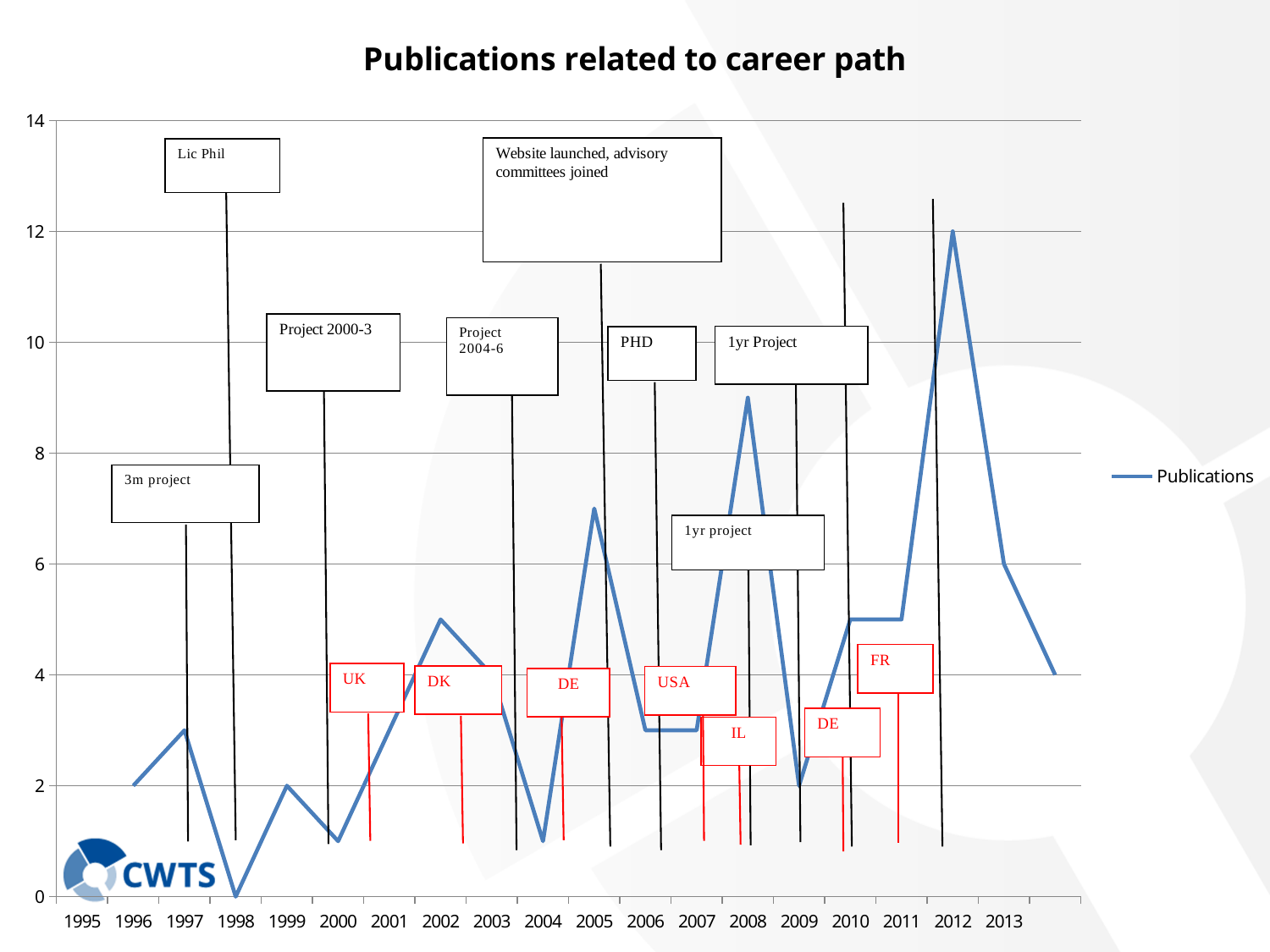
Is the value for Publications in 2009 greater or less than 4? less What is the value of Publications in 2012? 12 Do the publications rise or fall from 2012 to 2013? fall What is the value of Publications in 1998? 0 What type of chart is shown on the slide? line chart In which year does the Publications line reach its lowest value? 1998 Is the value for Publications in 2008 greater or less than 8? greater How many series does the legend list? 1 What is the name of the series shown in the legend? Publications In which year does the Publications line reach its highest value? 2012 Which year has more publications, 2005 or 2008? 2008 What is the title of the chart? Publications related to career path